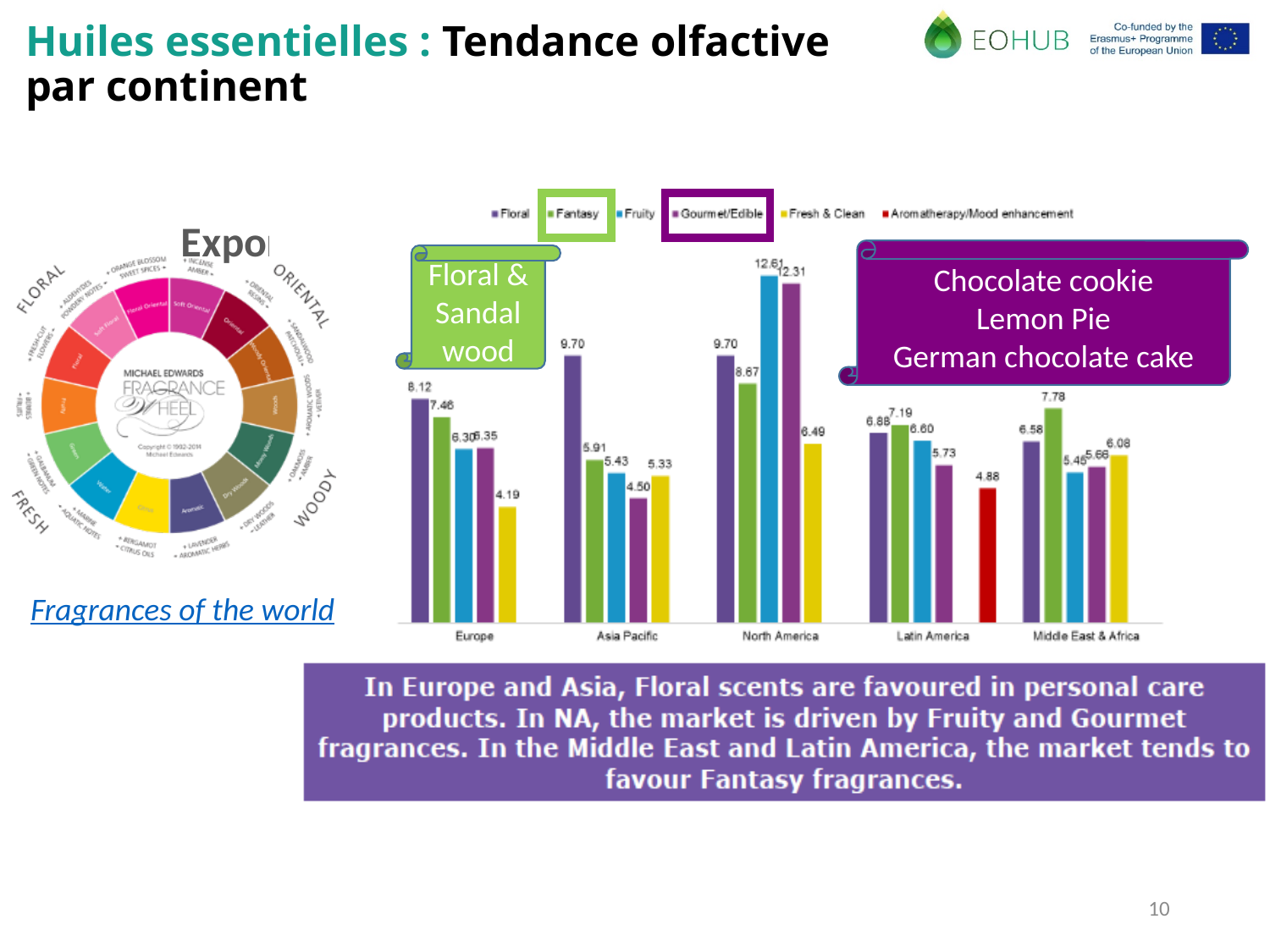
Which series has the lowest value in Europe? Fresh & Clean What is the difference between the Floral and Fantasy values in Asia Pacific? 3.79 What is the value for Floral in Europe? 8.12 Which series has the highest value in Asia Pacific? Floral Which region has the highest Fruity value? North America How many regions are shown on the x axis of the chart? 5 What is the value for Aromatherapy/Mood enhancement in Latin America? 4.88 What is the value for Fantasy in Middle East & Africa? 7.78 What type of chart is shown on the slide? bar chart How many series does the chart legend list? 6 What is the value for Fruity in North America? 12.61 Which is larger in Latin America, Fantasy or Floral? Fantasy